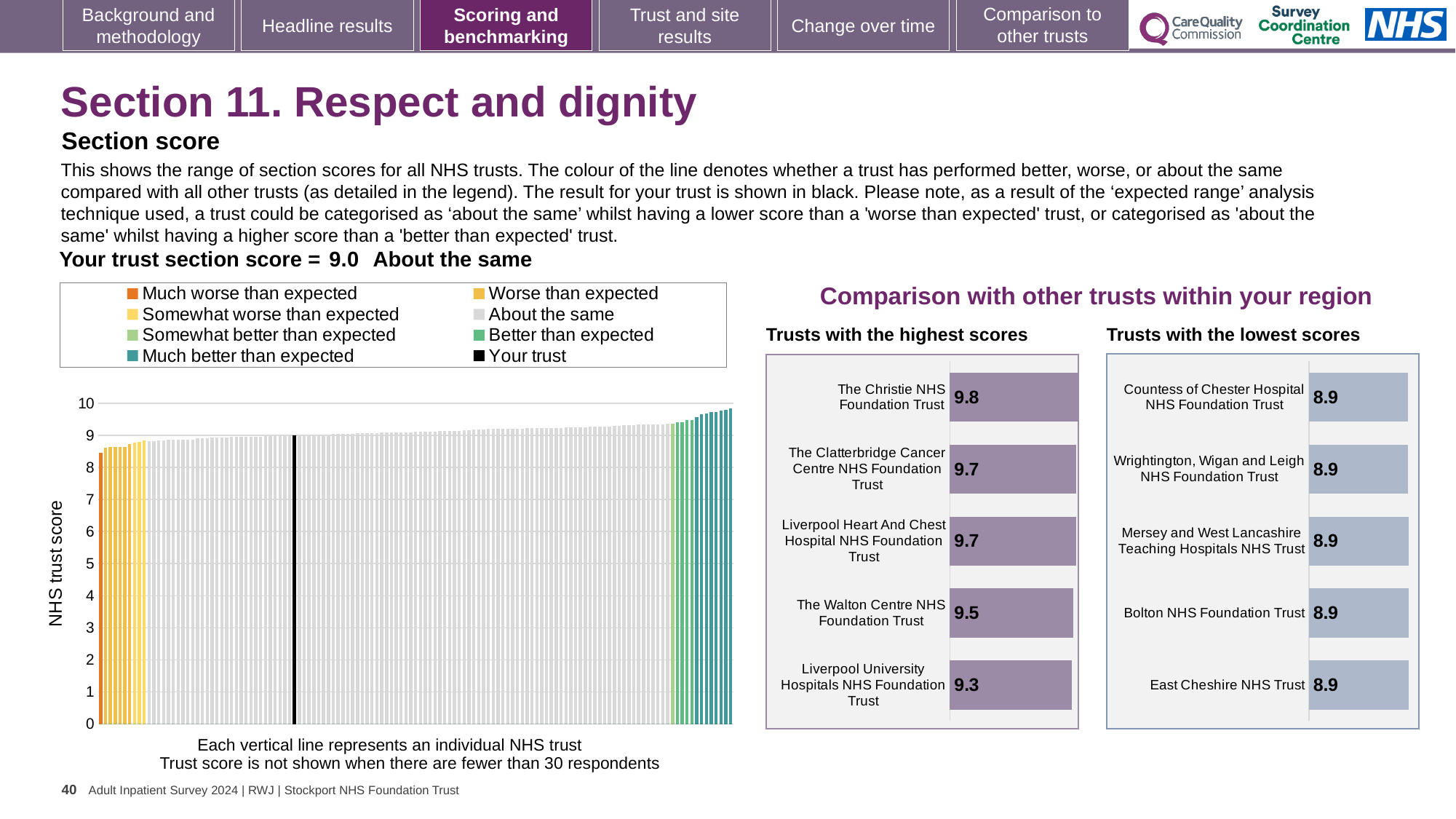
In the 'Trusts with the highest scores' chart, what is the score for The Christie NHS Foundation Trust? 9.8 In the large chart on the left showing NHS trust scores, do the values rise or fall from left to right along the x axis? Rise In the 'Trusts with the highest scores' chart, which trust has the highest score? The Christie NHS Foundation Trust In the 'Trusts with the lowest scores' chart, how many trusts are listed? 5 In the large chart on the left showing NHS trust scores, how many entries does the legend list? 8 In the large chart on the left showing NHS trust scores, what kind of chart is it? Bar chart In the 'Trusts with the lowest scores' chart, what is the score for East Cheshire NHS Trust? 8.9 In the 'Trusts with the highest scores' chart, what is the difference between the scores of The Christie NHS Foundation Trust and Liverpool University Hospitals NHS Foundation Trust? 0.5 In the 'Trusts with the highest scores' chart, which trust has the lowest score? Liverpool University Hospitals NHS Foundation Trust In the 'Trusts with the lowest scores' chart, what is the score for Bolton NHS Foundation Trust? 8.9 In the 'Trusts with the highest scores' chart, how many trusts are listed? 5 In the 'Trusts with the highest scores' chart, what is the score for The Walton Centre NHS Foundation Trust? 9.5